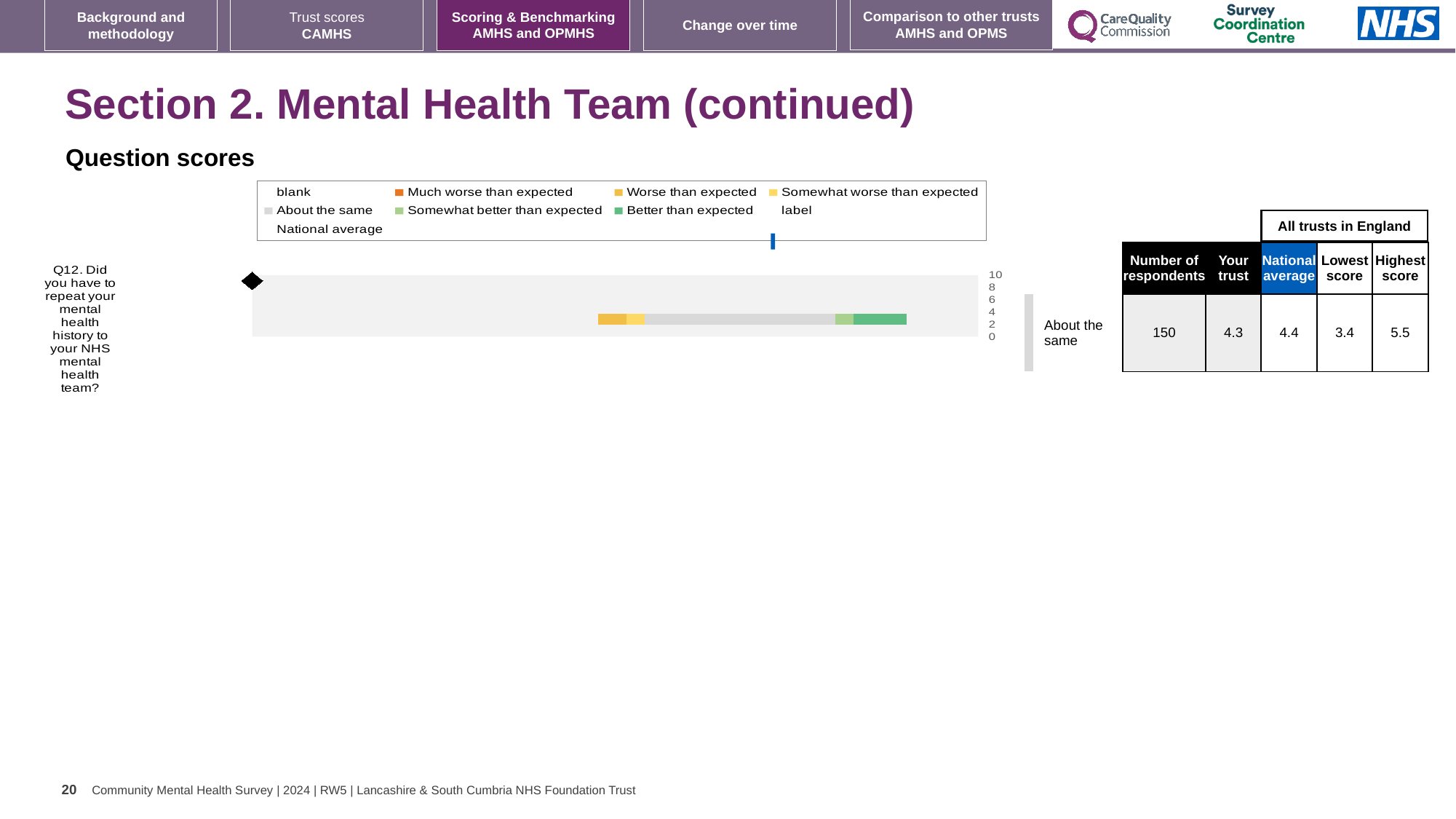
What benchmark category is the trust's Q12 score placed in? About the same What is the national average score for Q12? 4.4 Which question is plotted on the chart? Q12. Did you have to repeat your mental health history to your NHS mental health team? What is the difference between the highest and lowest trust scores for Q12? 2.1 How many respondents answered Q12? 150 What is the highest score among all trusts in England for Q12? 5.5 What type of chart is used to show the Q12 question score? bar chart How many survey questions are plotted on the chart? 1 What is the 'Your trust' score for Q12? 4.3 Which is larger for Q12, the trust's score or the national average? national average What is the lowest score among all trusts in England for Q12? 3.4 What is the maximum value shown on the chart's score axis? 10